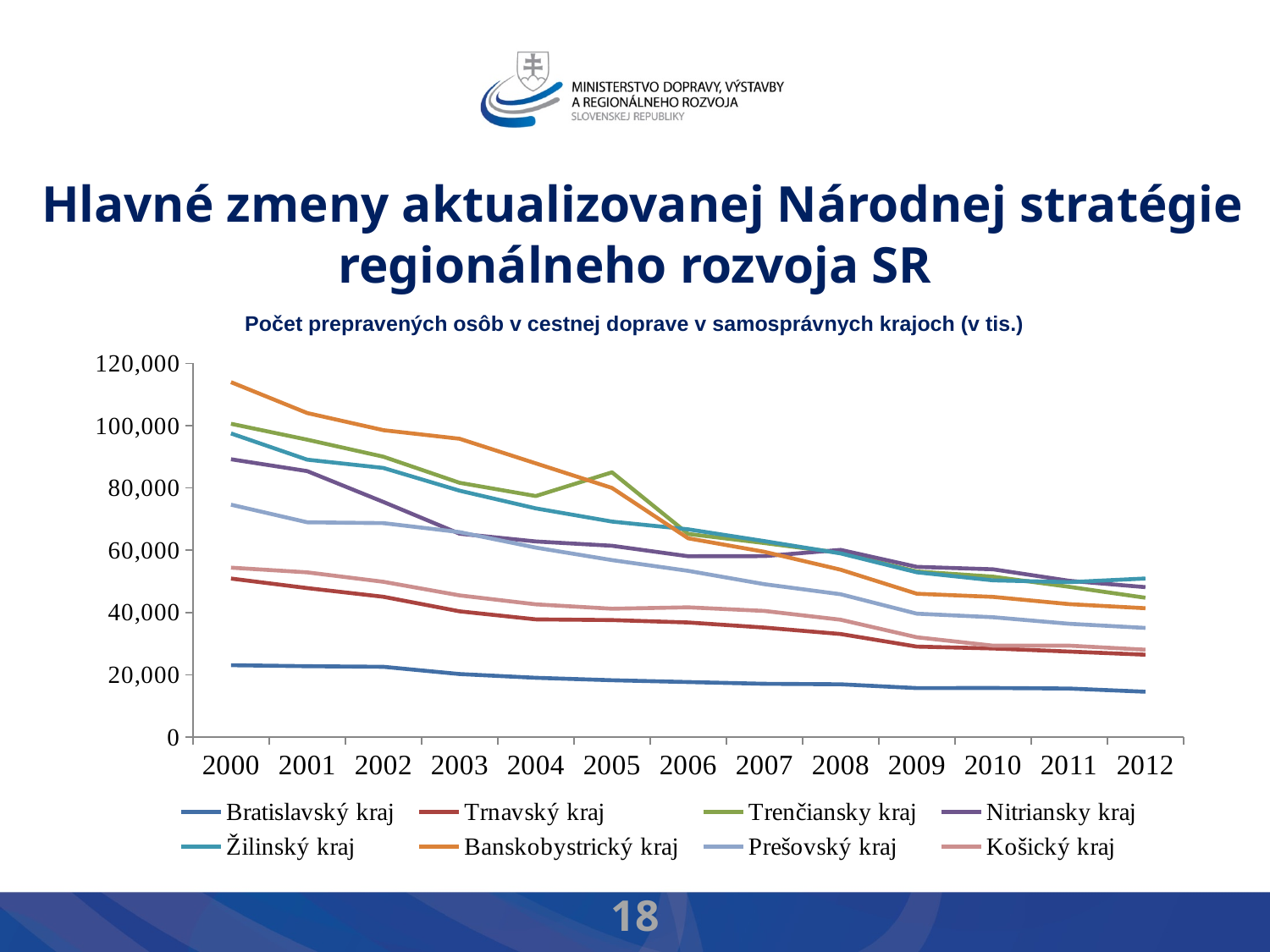
Is the value for Bratislavský kraj in 2012 greater or less than 20,000? less Is the value for Prešovský kraj in 2000 greater or less than 80,000? less How many years are shown along the x axis? 13 Does the value for Bratislavský kraj rise or fall from 2000 to 2012? fall What is the title of the chart? Počet prepravených osôb v cestnej doprave v samosprávnych krajoch (v tis.) Which is larger in 2000, the value for Trnavský kraj or Bratislavský kraj? Trnavský kraj How many series does the legend list? 8 Is the value for Bratislavský kraj in 2000 greater or less than 40,000? less Which region had the highest value in 2000? Banskobystrický kraj What kind of chart is shown on the slide? line chart Which region had the lowest value in 2000? Bratislavský kraj